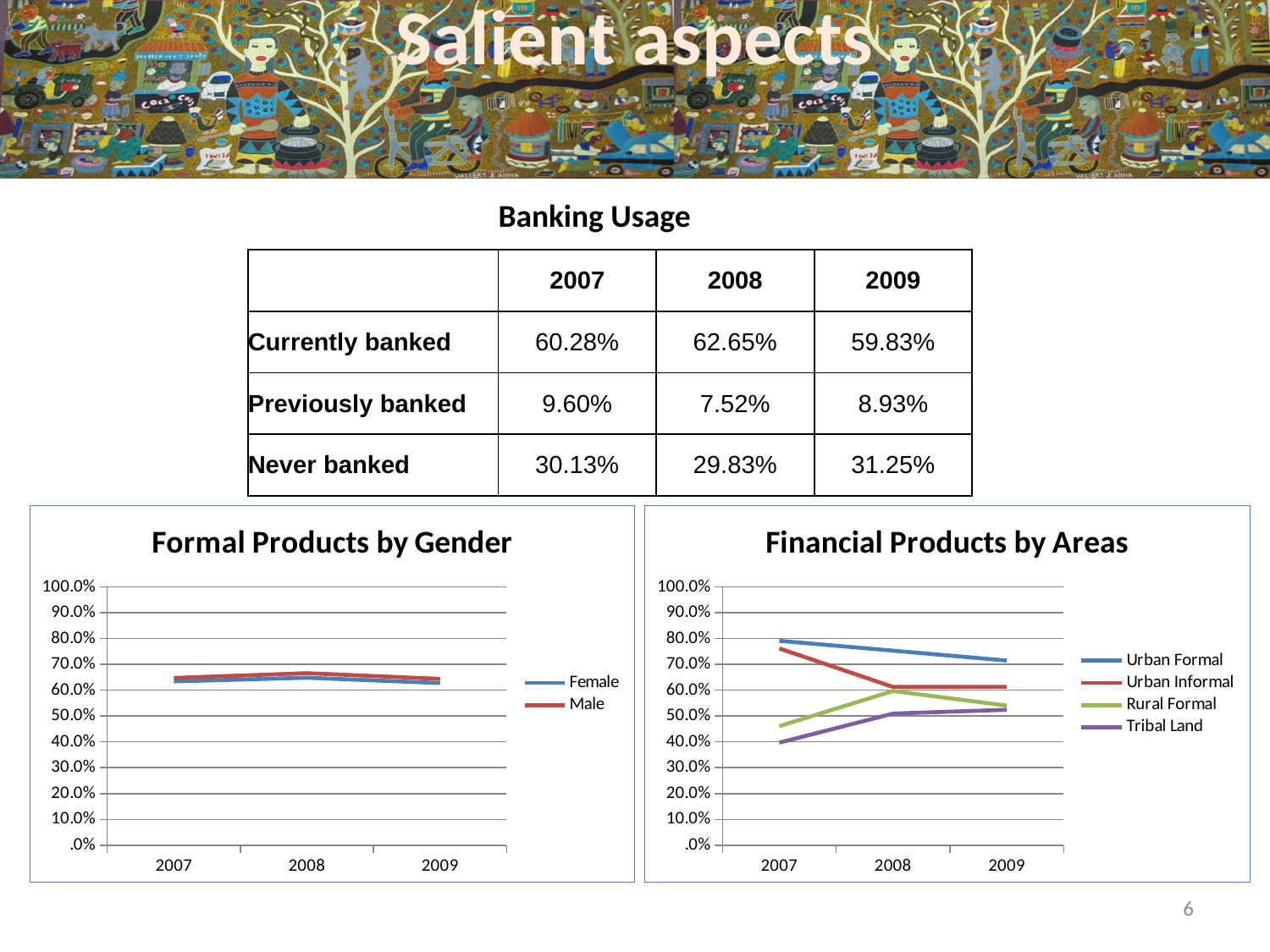
In "Financial Products by Areas", which series has the lowest value in 2007? Tribal Land In "Formal Products by Gender", which series is drawn in red? Male In "Formal Products by Gender", is the value for Female in 2007 greater or less than 50.0%? greater In "Financial Products by Areas", does the Urban Formal line rise or fall from 2007 to 2009? fall How many years are shown on the x axis of "Financial Products by Areas"? 3 What kind of chart is "Financial Products by Areas"? line chart What kind of chart is "Formal Products by Gender"? line chart In "Financial Products by Areas", does the Tribal Land line rise or fall from 2007 to 2009? rise How many series does the legend of "Financial Products by Areas" list? 4 How many series does the legend of "Formal Products by Gender" list? 2 In "Financial Products by Areas", is the value for Tribal Land in 2007 greater or less than 50.0%? less In "Financial Products by Areas", which is larger in 2007: Urban Formal or Tribal Land? Urban Formal